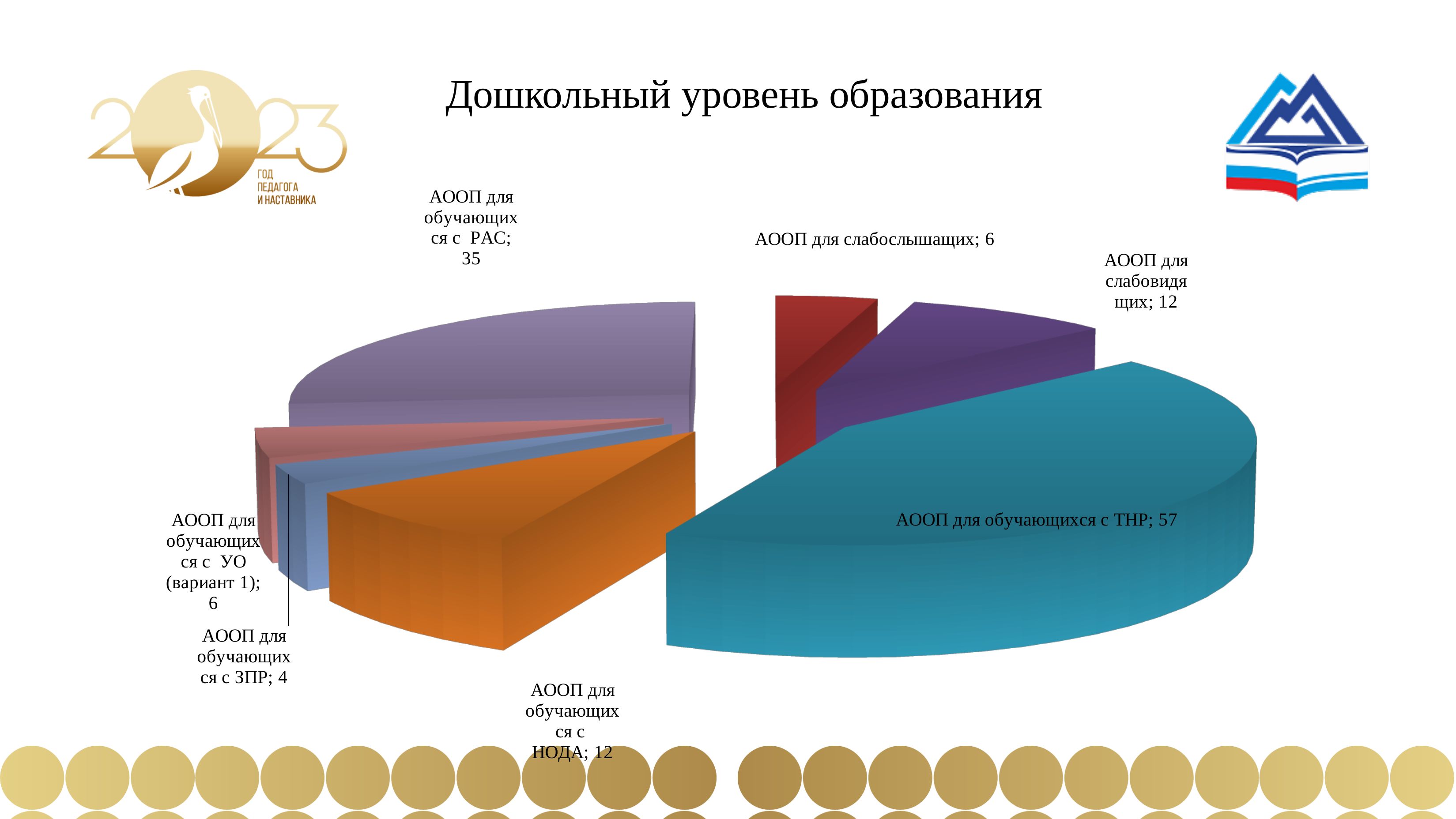
What is the value for АООП для обучающихся с ЗПР? 4 What is the value for АООП для слабослышащих? 6 What is the value for АООП для обучающихся с РАС? 35 What is the title of the chart on the slide? Дошкольный уровень образования What is the difference between the values for АООП для обучающихся с ТНР and АООП для обучающихся с РАС? 22 Which category has the smallest slice of the pie? АООП для обучающихся с ЗПР What is the value for АООП для обучающихся с ТНР? 57 Which is larger: the value for АООП для обучающихся с РАС or the value for АООП для слабовидящих? АООП для обучающихся с РАС Which category has the largest slice of the pie? АООП для обучающихся с ТНР What kind of chart is shown on the slide? pie chart How many slices does the pie chart have? 7 What is the sum of all the values shown in the pie chart? 132